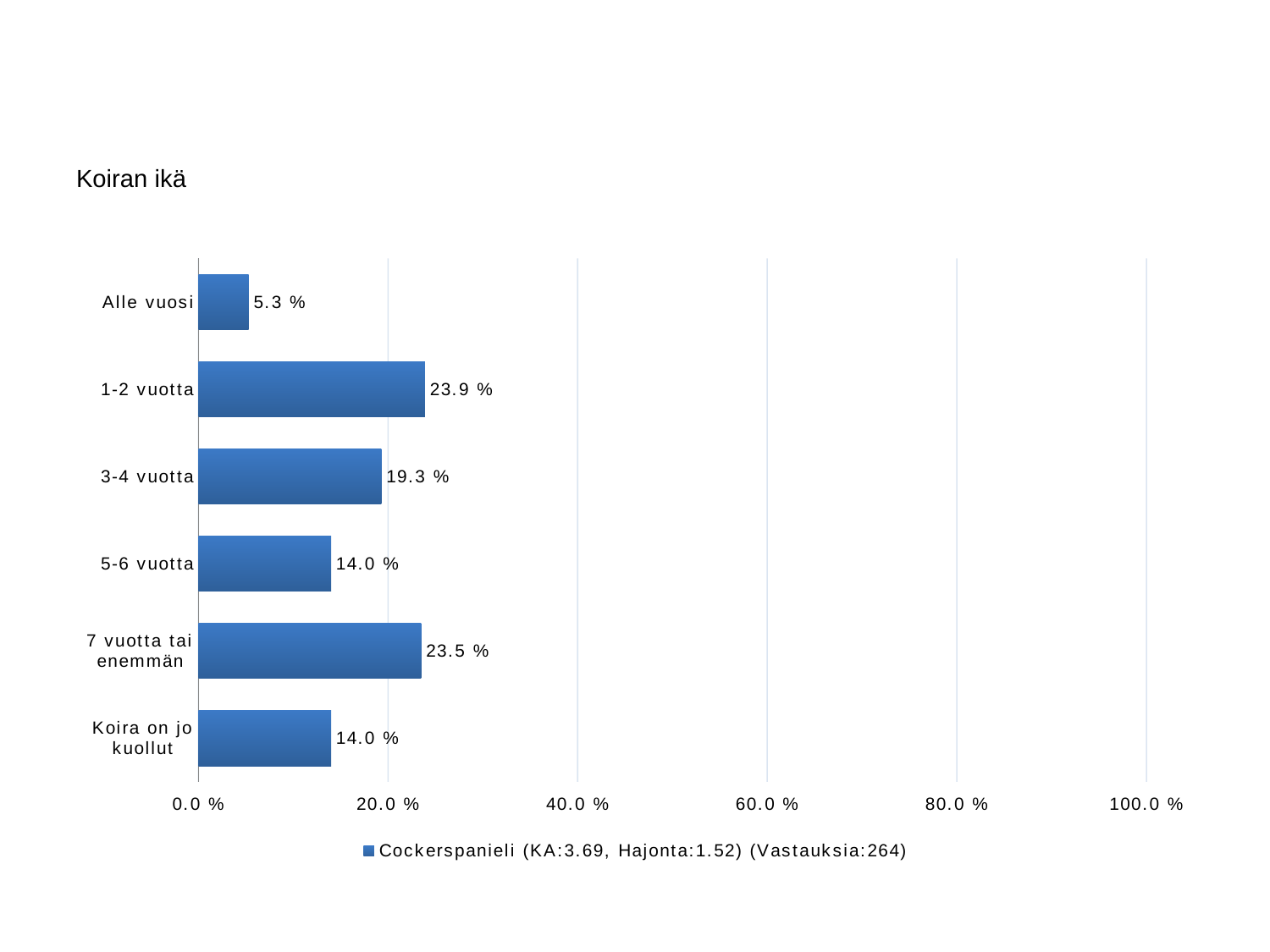
What is the difference between the values for "1-2 vuotta" and "3-4 vuotta"? 4.6 % What is the value for "Alle vuosi"? 5.3 % What kind of chart is shown on the slide? bar chart How many responses (Vastauksia) does the legend entry report? 264 How many categories are shown in the chart? 6 What is the value for "7 vuotta tai enemmän"? 23.5 % Which category has the lowest value? Alle vuosi Which is larger, the value for "3-4 vuotta" or the value for "5-6 vuotta"? 3-4 vuotta What is the value for "1-2 vuotta"? 23.9 % What is the title of the chart? Koiran ikä Is the value for "7 vuotta tai enemmän" greater or less than 20.0 %? greater How many series does the legend list? 1